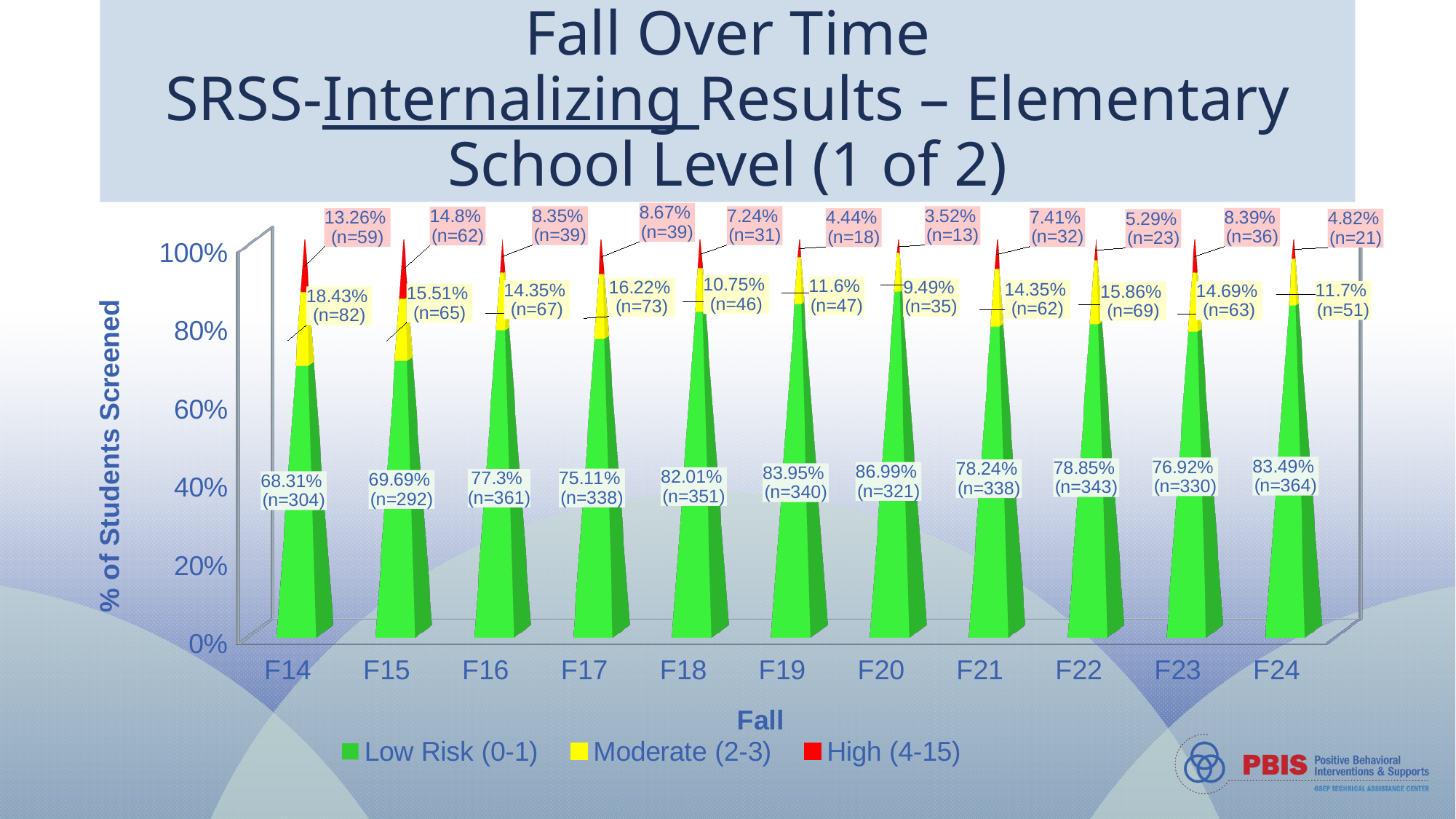
Which fall has the highest Low Risk (0-1) percentage? F20 Is the High (4-15) percentage larger in F15 or in F24? F15 What is the High (4-15) percentage for F14? 13.26% Which fall has the highest Moderate (2-3) percentage? F14 Which fall has the lowest High (4-15) percentage? F20 How many series does the legend list? 3 What kind of chart is shown on the slide? Stacked bar chart How many students (n) were in the Low Risk (0-1) group in F24? 364 What is the difference in Low Risk (0-1) percentage between F20 and F14? 18.68 percentage points What is the Moderate (2-3) percentage for F17? 16.22% How many fall time points are shown on the x axis? 11 What is the Low Risk (0-1) percentage for F20? 86.99%